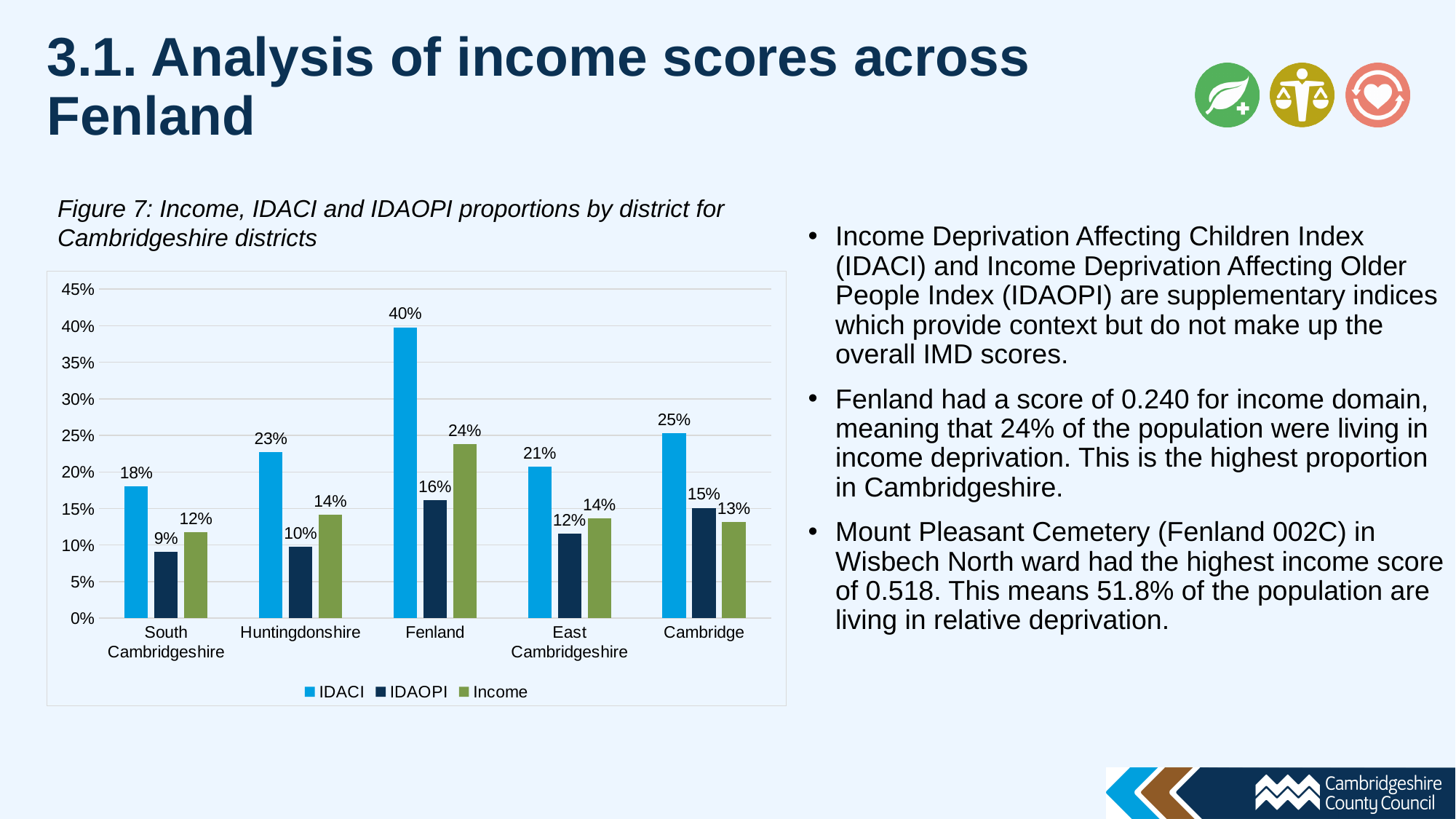
How many series does the legend list? 3 How many districts are shown on the x axis? 5 Is the IDACI value for Fenland greater or less than 35%? greater What is the difference between the IDACI value for Fenland and the IDACI value for Cambridge? 15% What is the IDACI value for Fenland? 40% Which district has the highest IDACI value? Fenland Which series is shown in light blue in the legend? IDACI What is the IDAOPI value for Cambridge? 15% Which district has the lowest IDAOPI value? South Cambridgeshire What kind of chart is shown on the slide? Bar chart Which is larger, the Income value for Huntingdonshire or the Income value for Cambridge? Huntingdonshire What is the Income value for South Cambridgeshire? 12%